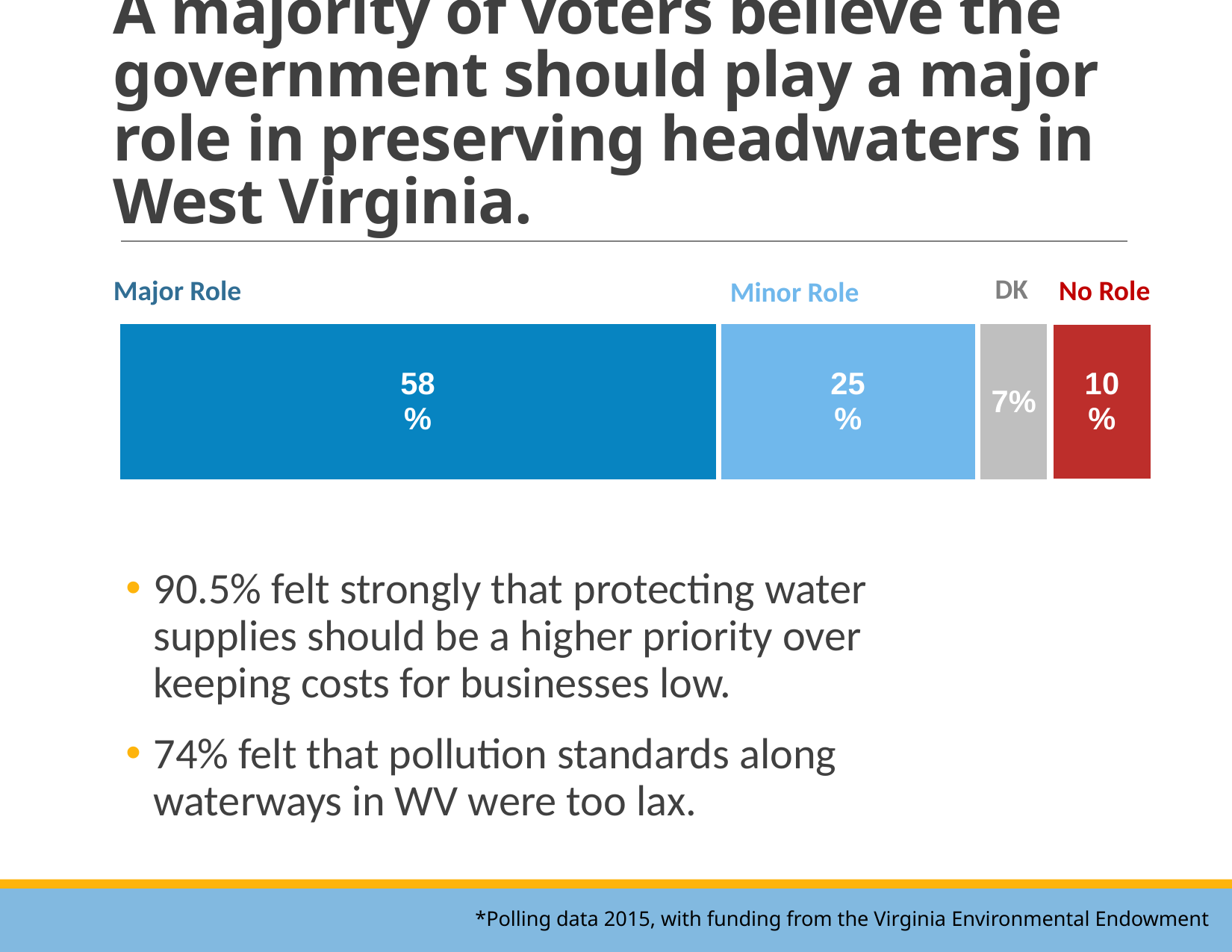
How many response categories are shown in the bar? 4 What percentage of voters answered DK (don't know)? 7% Which response has the largest share of voters? Major Role What percentage of voters said the government should play a Major Role? 58% Which is larger, the share for Minor Role or the share for No Role? Minor Role What is the difference in percentage points between No Role and DK? 3 What colour is the No Role segment of the bar? Red What percentage of voters said the government should play No Role? 10% What is the difference in percentage points between Major Role and Minor Role? 33 What kind of chart is shown on the slide? Bar chart Which response has the smallest share of voters? DK What percentage of voters said the government should play a Minor Role? 25%